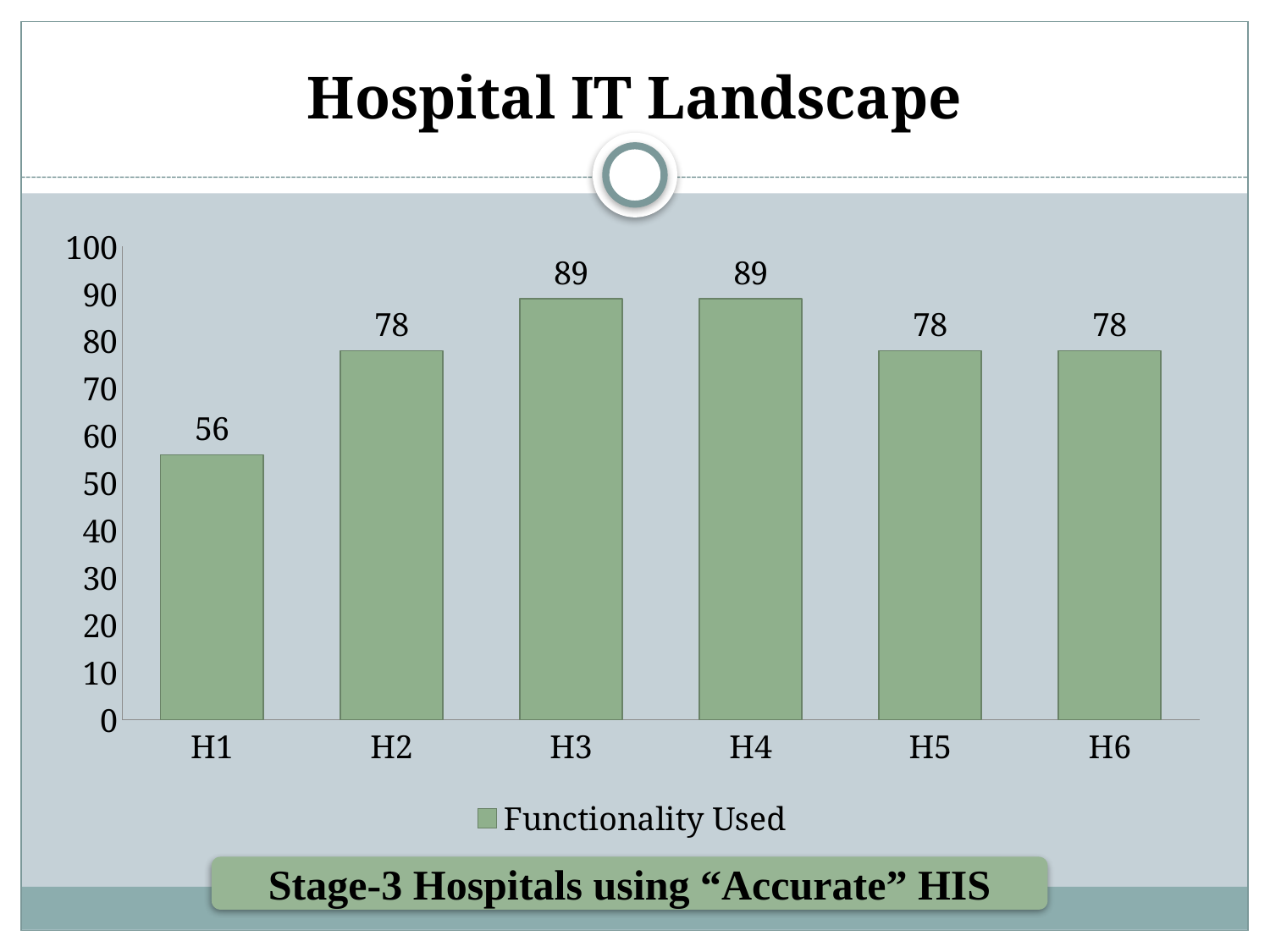
How many series does the legend list? 1 What is the value for H5? 78 What is the difference between the values for H2 and H1? 22 What is the difference between the values for H3 and H1? 33 What is the value for H1? 56 How many categories are shown on the x axis? 6 What is the value for H3? 89 What is the name of the series shown in the legend? Functionality Used Which is larger, the value for H4 or the value for H6? H4 What kind of chart is shown on the slide? bar chart Is the value for H1 greater or less than 60? less Which category has the lowest value? H1